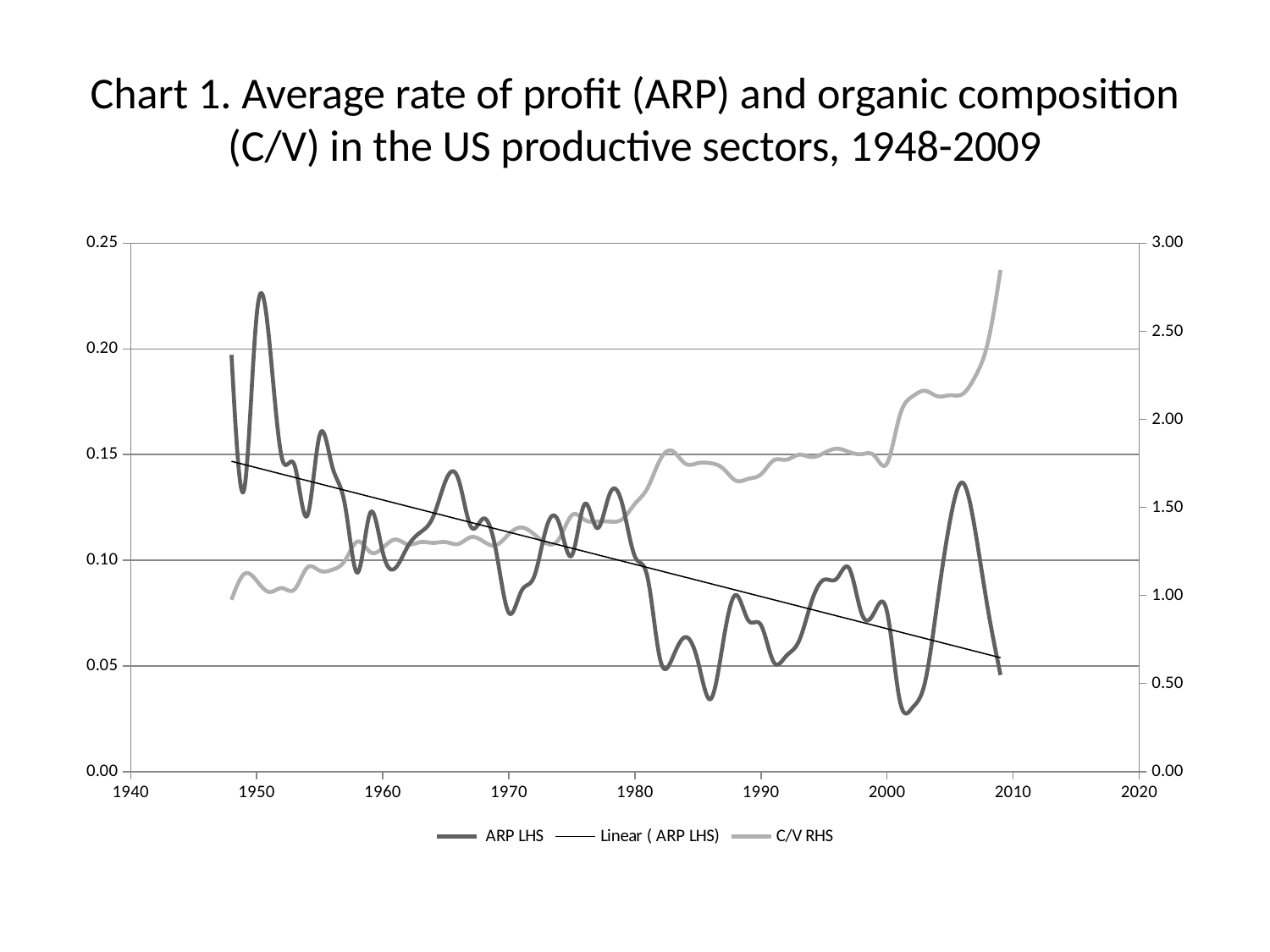
How many series does the legend list? 3 Is the ARP LHS value around 1986 greater or less than 0.05? less Does the C/V RHS series generally rise or fall from 1948 to 2009? rise Does the ARP LHS series generally rise or fall from 1948 to 2009? fall What is the title of the chart? Chart 1. Average rate of profit (ARP) and organic composition (C/V) in the US productive sectors, 1948-2009 Is the C/V RHS value around 1990 greater or less than 1.50? greater Is the ARP LHS value around 2006 greater or less than 0.10? greater What type of chart is shown on the slide? line chart What is the maximum value shown on the right-hand vertical axis? 3.00 Which is larger, the ARP LHS value around 1950 or around 2001? around 1950